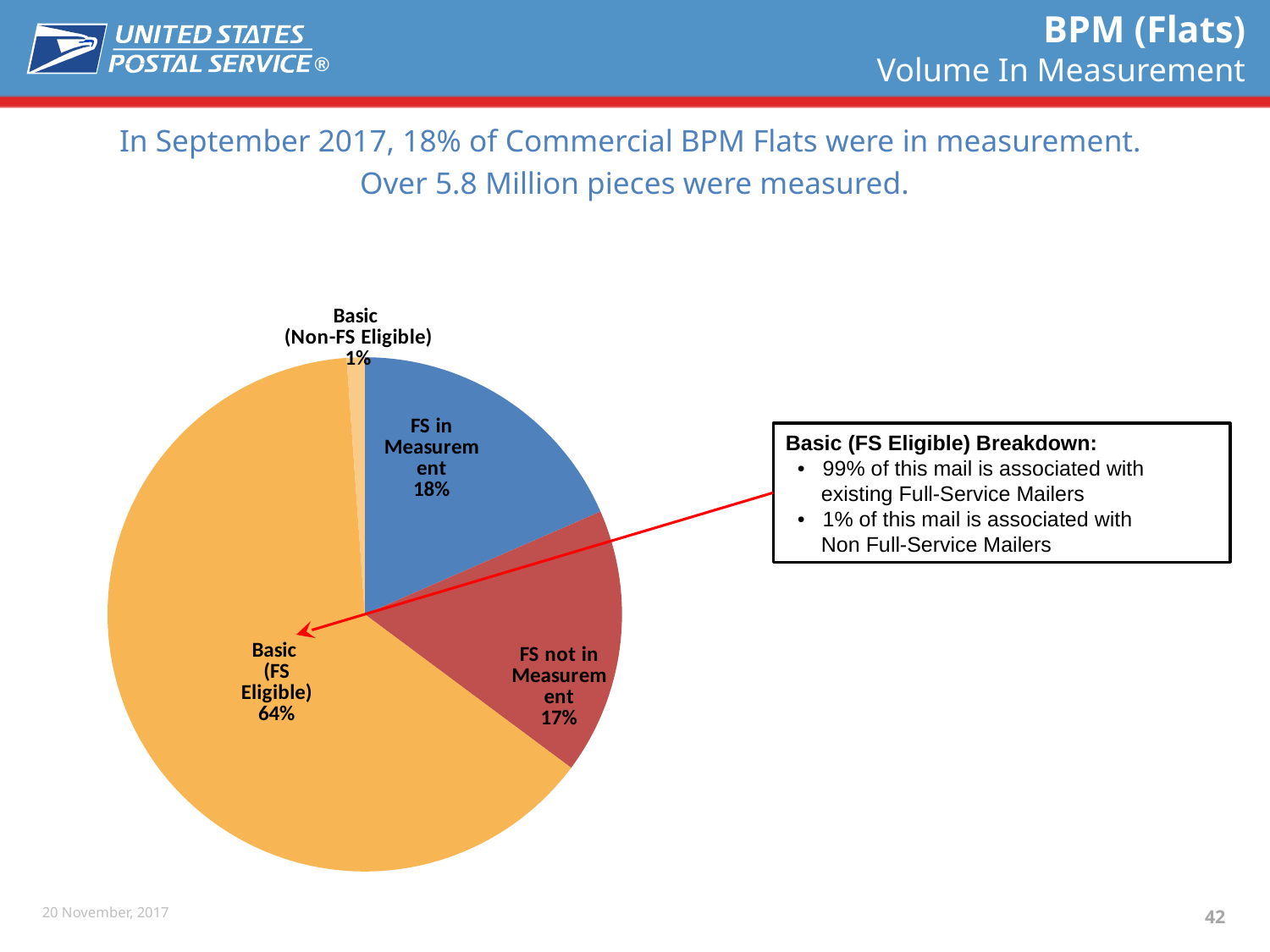
What is the difference in percentage points between FS in Measurement and FS not in Measurement? 1 Which is larger, the FS in Measurement slice or the Basic (Non-FS Eligible) slice? FS in Measurement Which slice of the pie is the largest? Basic (FS Eligible) What share of the pie is FS in Measurement? 18% What share of the pie is Basic (Non-FS Eligible)? 1% How many slices does the pie chart have? 4 What colour is the Basic (FS Eligible) slice? orange What kind of chart is shown on the slide? pie chart What share of the pie is Basic (FS Eligible)? 64% Which slice of the pie is the smallest? Basic (Non-FS Eligible) What is the difference in percentage points between Basic (FS Eligible) and FS in Measurement? 46